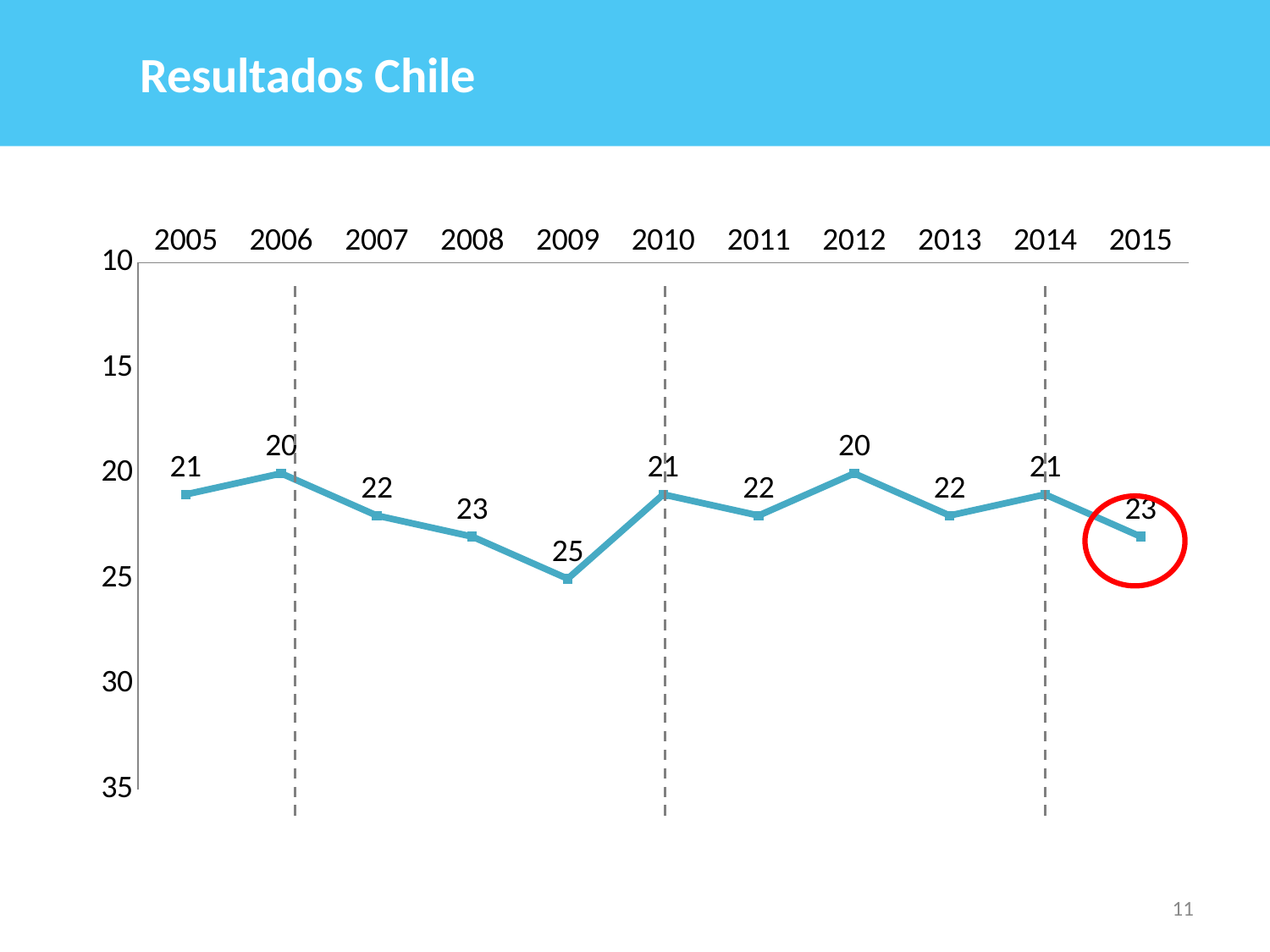
Which year has the largest value? 2009 What is the difference between the values for 2015 and 2014? 2 What is the value for 2012? 20 What is the value for 2005? 21 What kind of chart is shown on the slide? line chart Which has the larger value, 2008 or 2007? 2008 What is the value for 2015? 23 How many years are plotted on the chart? 11 What is the value for 2009? 25 Do the values rise or fall from 2005 to 2009? rise Which has the larger value, 2009 or 2010? 2009 What is the difference between the values for 2009 and 2005? 4